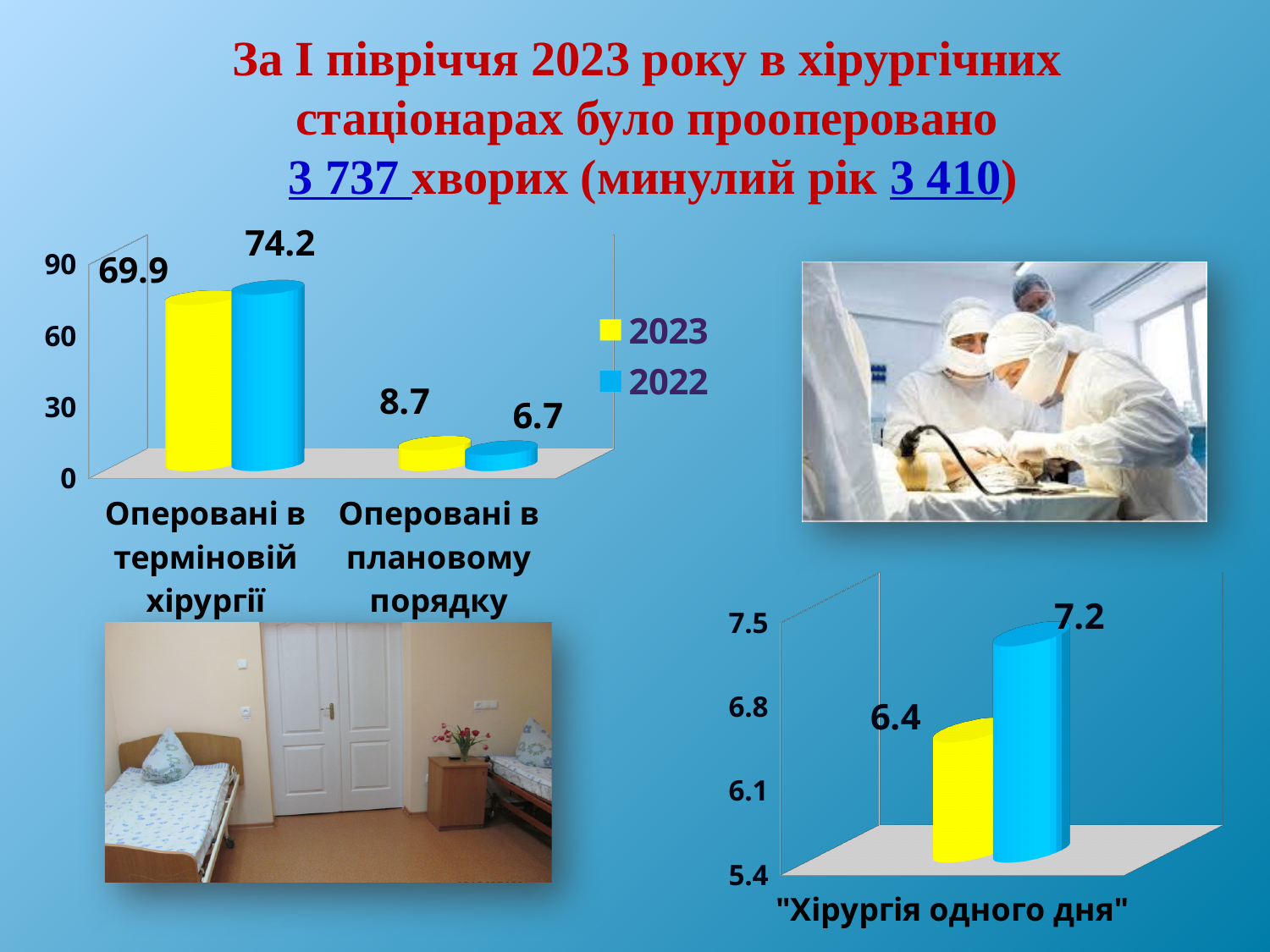
In the top-left chart, which year has the larger value for "Оперовані в плановому порядку"? 2023 What kind of chart is the bottom-right chart titled "Хірургія одного дня"? Bar chart In the top-left chart, what is the 2022 value for "Оперовані в плановому порядку"? 6.7 In the top-left chart, what is the 2023 value for "Оперовані в плановому порядку"? 8.7 In the top-left chart, which colour represents 2023 in the legend? Yellow In the top-left chart, what is the 2023 value for "Оперовані в терміновій хірургії"? 69.9 In the bottom-right chart titled "Хірургія одного дня", what is the value of the yellow bar? 6.4 In the bottom-right chart titled "Хірургія одного дня", what is the value of the blue bar? 7.2 In the top-left chart, what is the 2022 value for "Оперовані в терміновій хірургії"? 74.2 In the top-left chart, what is the difference between the 2022 and 2023 values for "Оперовані в терміновій хірургії"? 4.3 In the top-left chart, how many series does the legend list? 2 In the top-left chart, how many categories are shown on the x axis? 2